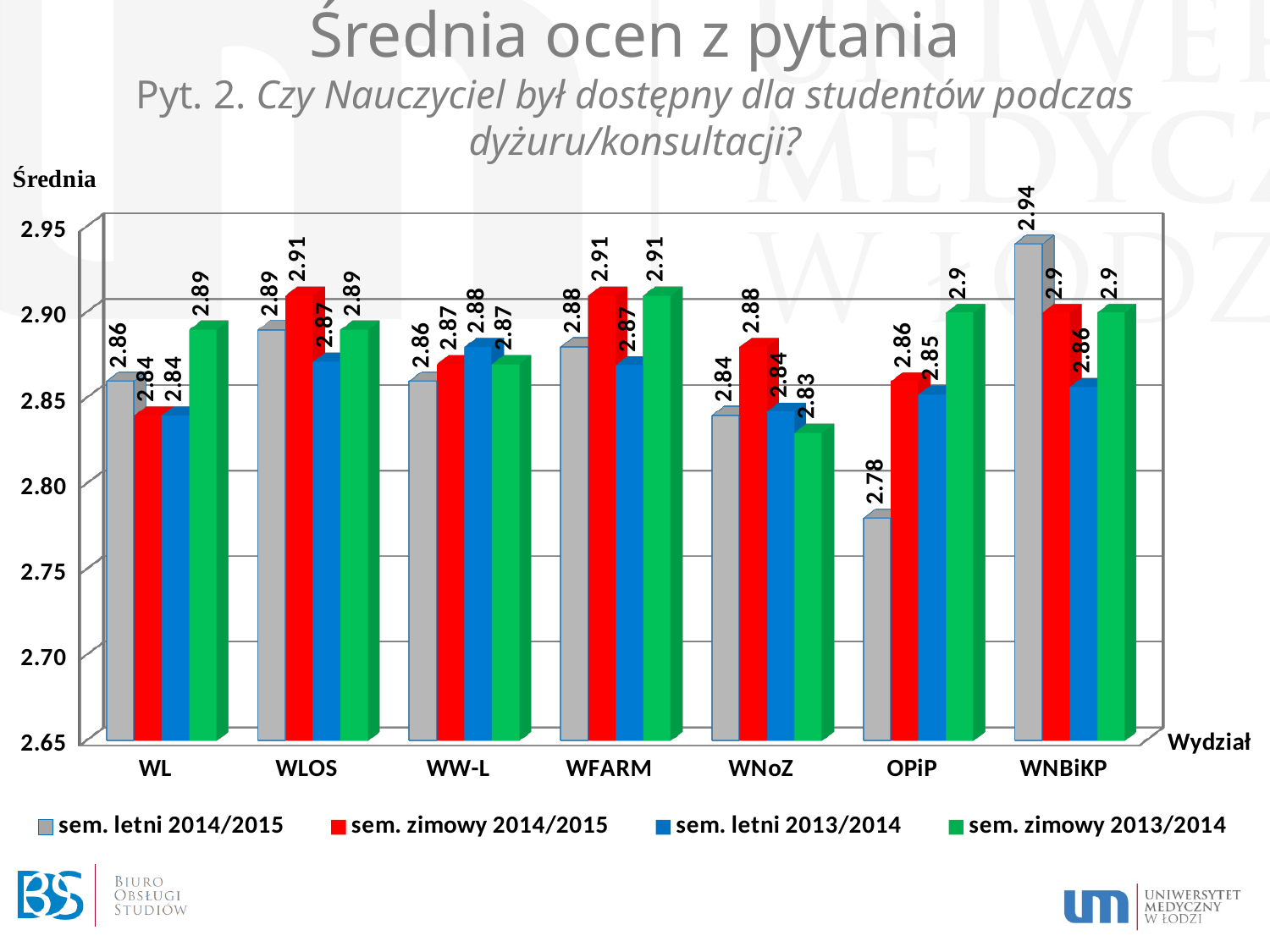
Which colour represents the sem. zimowy 2013/2014 series? green What is the difference between the sem. letni 2014/2015 values for WNBiKP and OPiP? 0.16 How many categories (Wydział) are shown on the x axis? 7 Which is larger for WNoZ: the sem. zimowy 2014/2015 value or the sem. zimowy 2013/2014 value? sem. zimowy 2014/2015 What kind of chart is shown on the slide? bar chart What is the value for OPiP in the sem. letni 2014/2015 series? 2.78 What is the value for WW-L in the sem. letni 2013/2014 series? 2.88 Which category has the highest value in the sem. letni 2014/2015 series? WNBiKP What is the value for WNBiKP in the sem. letni 2014/2015 series? 2.94 How many series does the legend list? 4 Which category has the lowest value in the sem. letni 2014/2015 series? OPiP What is the value for WNoZ in the sem. zimowy 2014/2015 series? 2.88